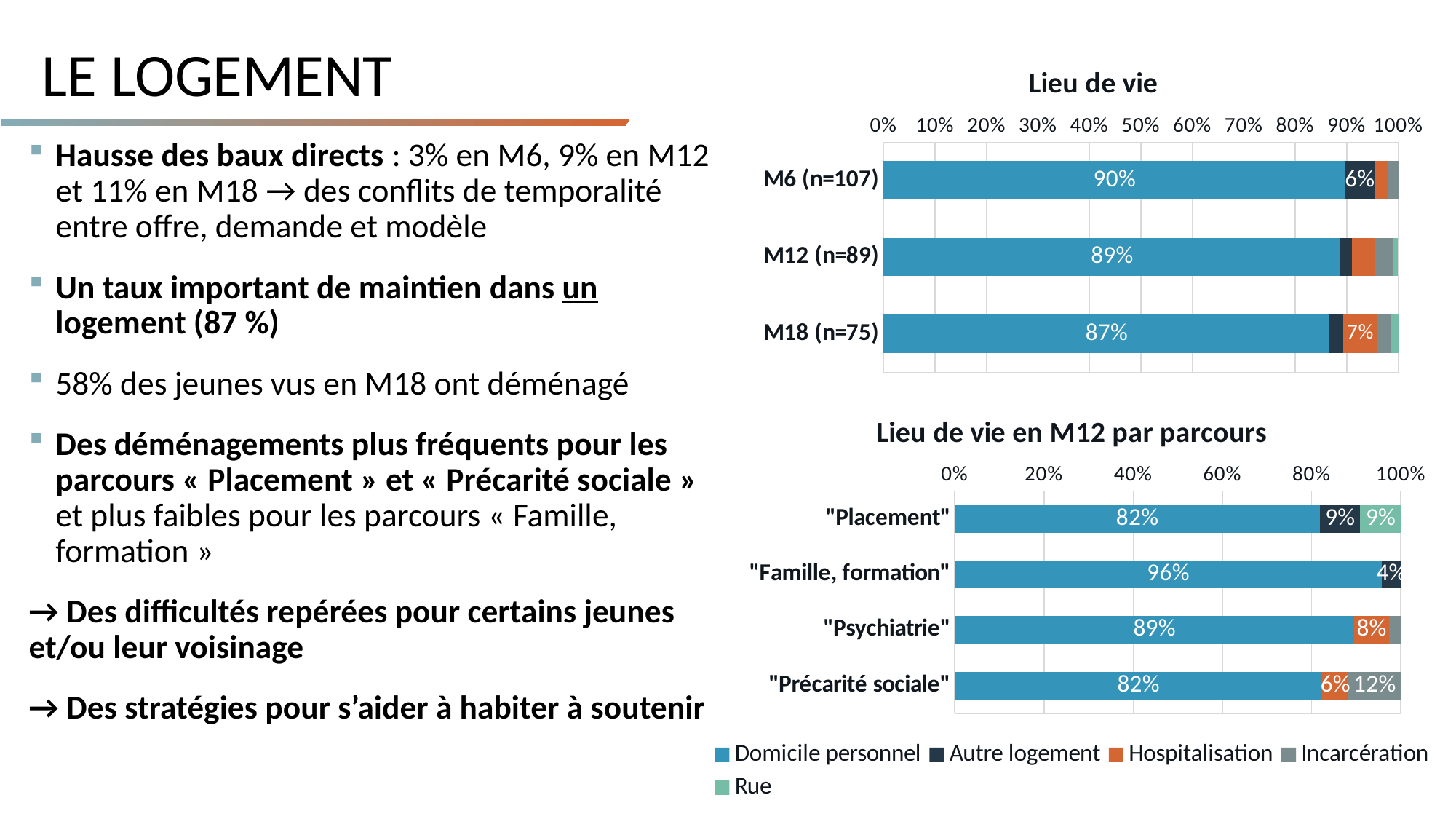
What kind of chart is 'Lieu de vie en M12 par parcours'? Stacked bar chart In the 'Lieu de vie en M12 par parcours' chart, what is the Domicile personnel value for "Famille, formation"? 96% In the 'Lieu de vie en M12 par parcours' chart, which is larger: the Domicile personnel value for "Psychiatrie" or for "Placement"? "Psychiatrie" How many series does the legend list? 5 In the 'Lieu de vie' chart, what is the difference between the Domicile personnel values for M6 (n=107) and M18 (n=75)? 3% In the 'Lieu de vie' chart, what is the Domicile personnel value for M6 (n=107)? 90% In the 'Lieu de vie en M12 par parcours' chart, which parcours has the lowest Domicile personnel value? "Placement" and "Précarité sociale" (both 82%) In the 'Lieu de vie' chart, what is the Domicile personnel value for M18 (n=75)? 87% In the 'Lieu de vie' chart, which category has the highest Domicile personnel value? M6 (n=107) In the 'Lieu de vie' chart, what is the Hospitalisation value for M18 (n=75)? 7% In the 'Lieu de vie' chart, how many categories are shown? 3 In the 'Lieu de vie en M12 par parcours' chart, what is the Incarcération value for "Précarité sociale"? 12%